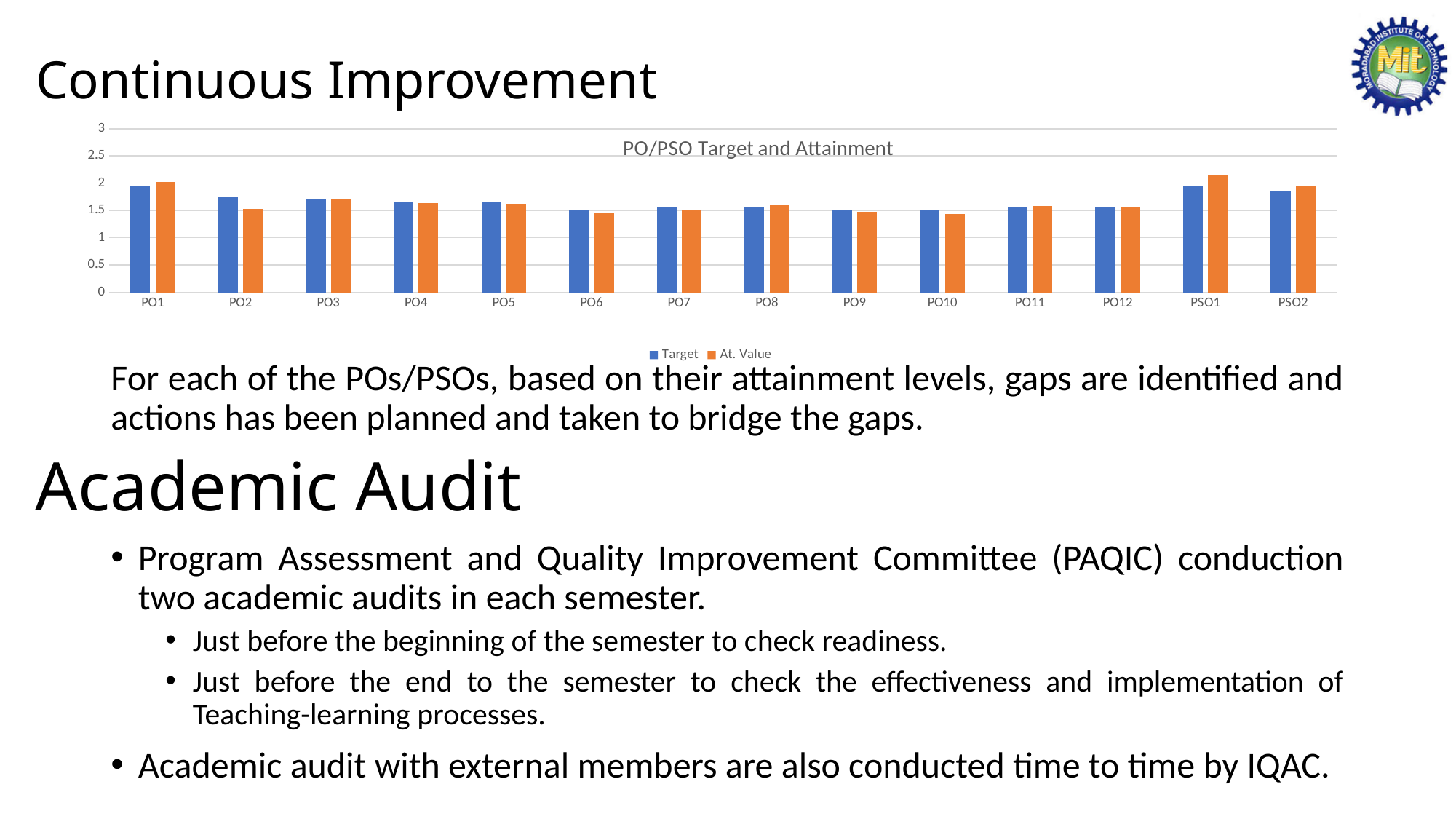
Is the At. Value for PSO1 greater or less than 2? greater For PSO1, which is larger: the Target or the At. Value? At. Value Which category has the highest At. Value bar? PSO1 For PO2, which is larger: the Target or the At. Value? Target What are the two series named in the chart legend? Target and At. Value How many series does the chart legend list? 2 Is the Target value for PO2 greater or less than 1.5? greater What kind of chart is shown on the slide? bar chart How many categories are shown along the x axis of the chart? 14 What is the title of the chart? PO/PSO Target and Attainment